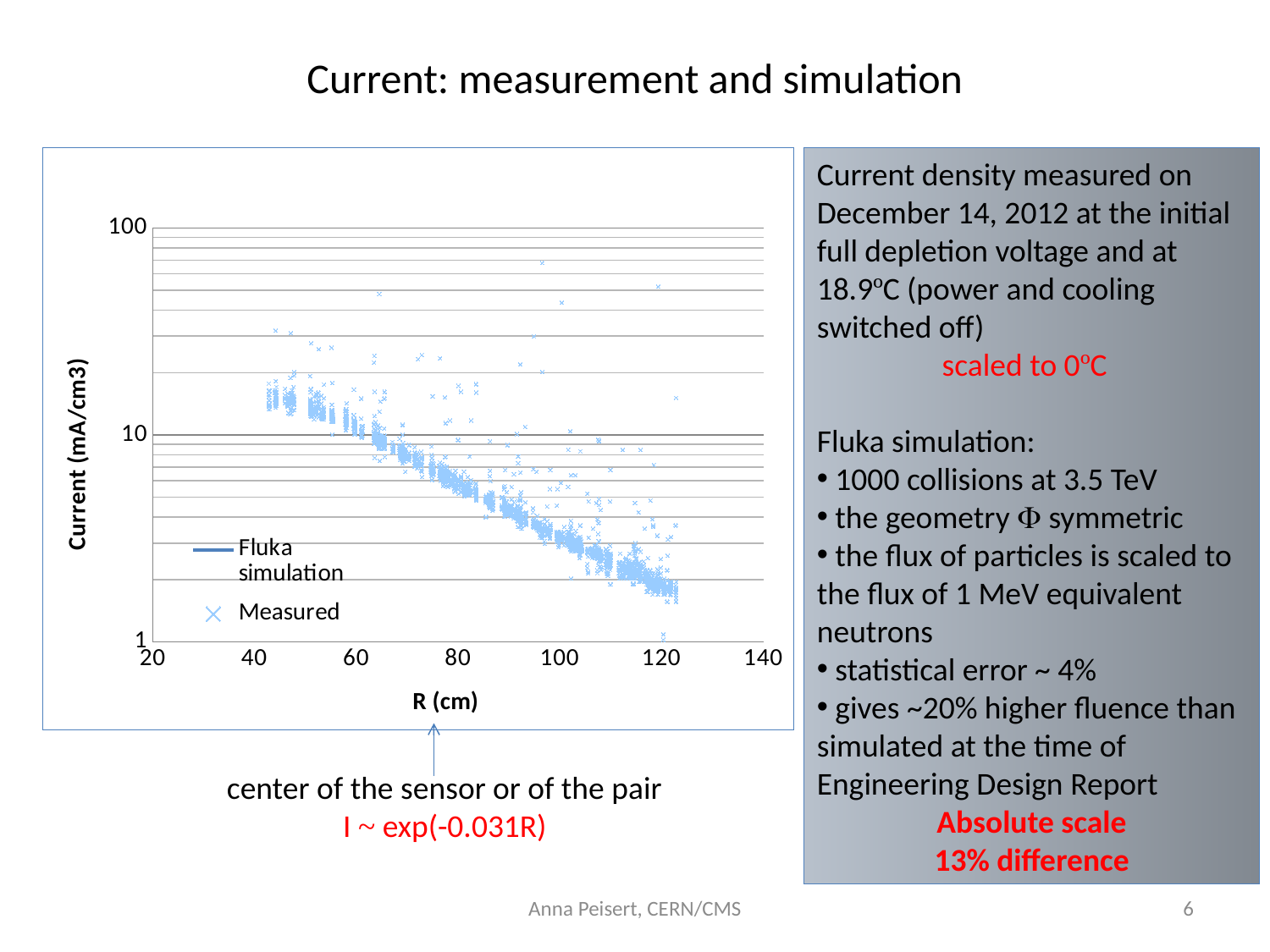
What are the two series named in the chart legend? Fluka simulation and Measured What is the highest value shown on the y axis of the chart? 100 Do the measured current values rise or fall as R increases along the x axis? fall Is the measured current at R = 45 cm greater or less than 10 mA/cm3? greater How many series does the chart legend list? 2 What kind of chart is shown on the slide? scatter chart What is the label of the x axis of the chart? R (cm)